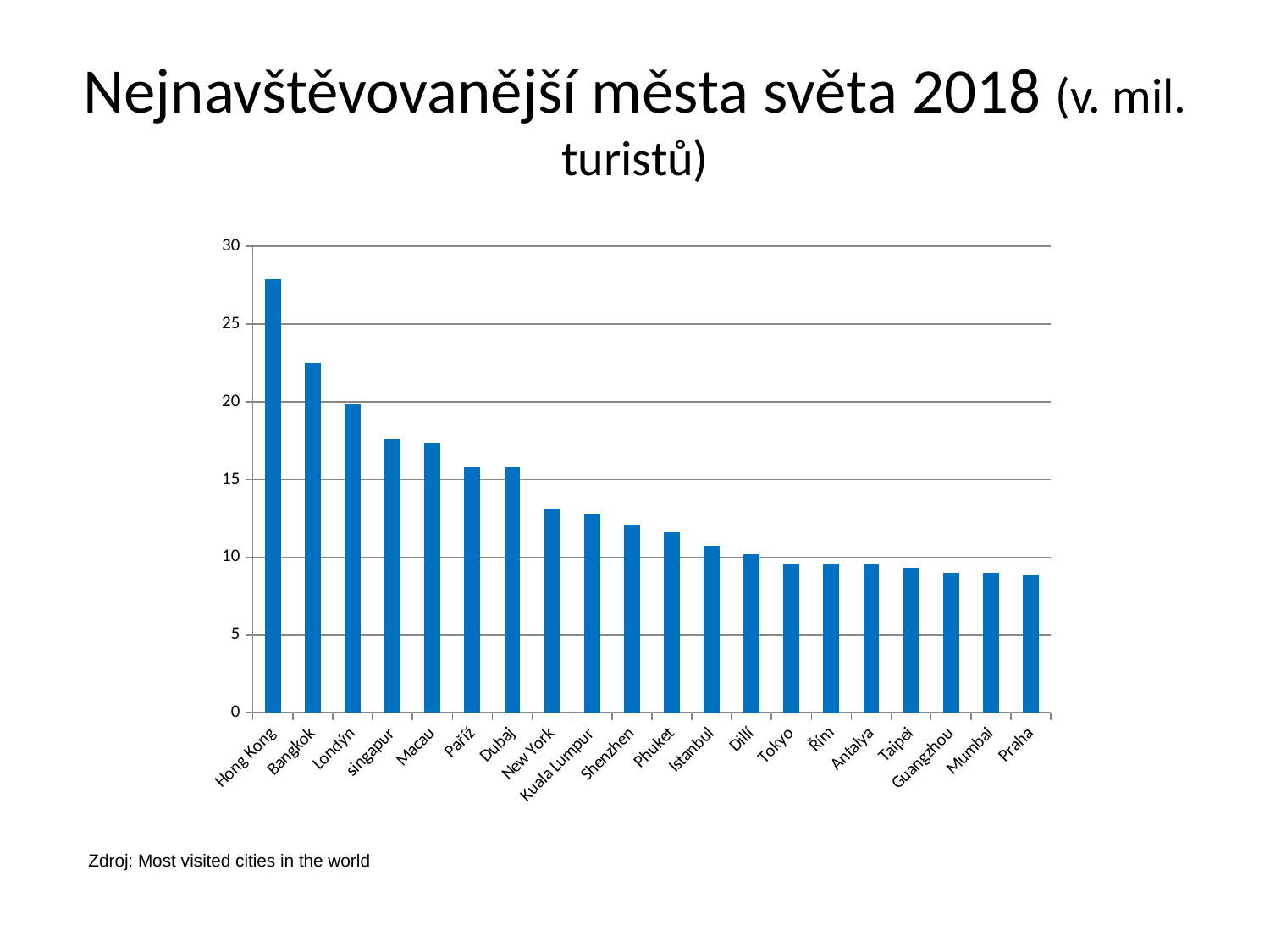
What is the title of the chart on the slide? Nejnavštěvovanější města světa 2018 (v. mil. turistů) Is the value for New York greater or less than 15? less How many cities are shown on the chart? 20 Is the value for Macau greater or less than 20? less Is the value for Praha greater or less than 10? less Which city has the lowest value on the chart? Praha Which city has the highest value on the chart? Hong Kong What kind of chart is shown on the slide? bar chart Do the values rise or fall from left to right along the x axis? fall Which has the larger value, Bangkok or Londýn? Bangkok